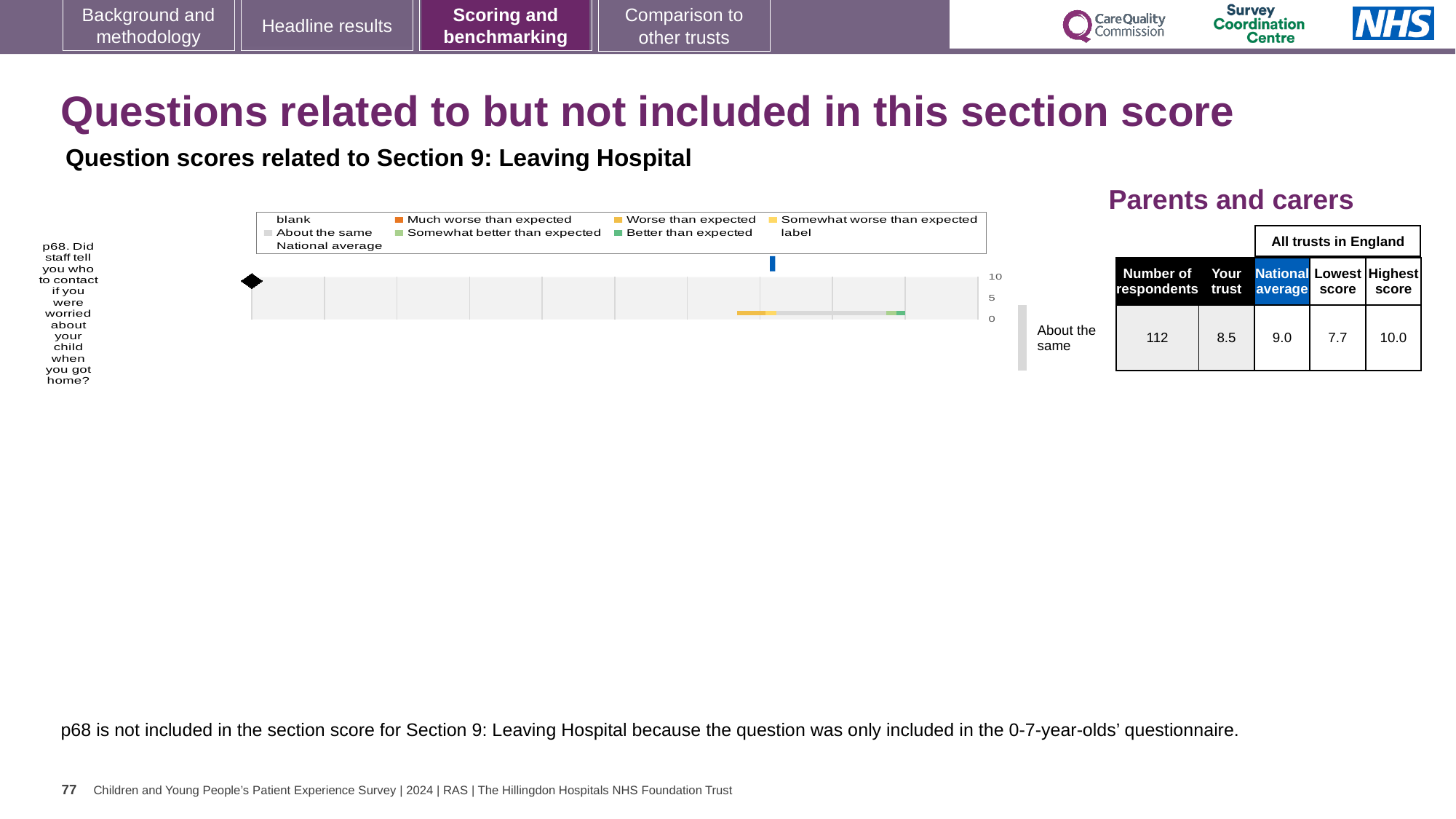
What is the national average score for p68? 9.0 What is the 'Your trust' score for p68? 8.5 What kind of chart is shown on the slide? bar chart How many questions are plotted in the chart? 1 How many respondents answered p68? 112 What is the highest score among all trusts in England for p68? 10.0 Is the 'Your trust' score for p68 greater or less than 5? greater Which question number is plotted in the chart? p68 Which is larger for p68, the 'Your trust' score or the national average? national average What benchmark category is shown next to the chart for p68? About the same What is the difference between the national average and the 'Your trust' score for p68? 0.5 What is the lowest score among all trusts in England for p68? 7.7